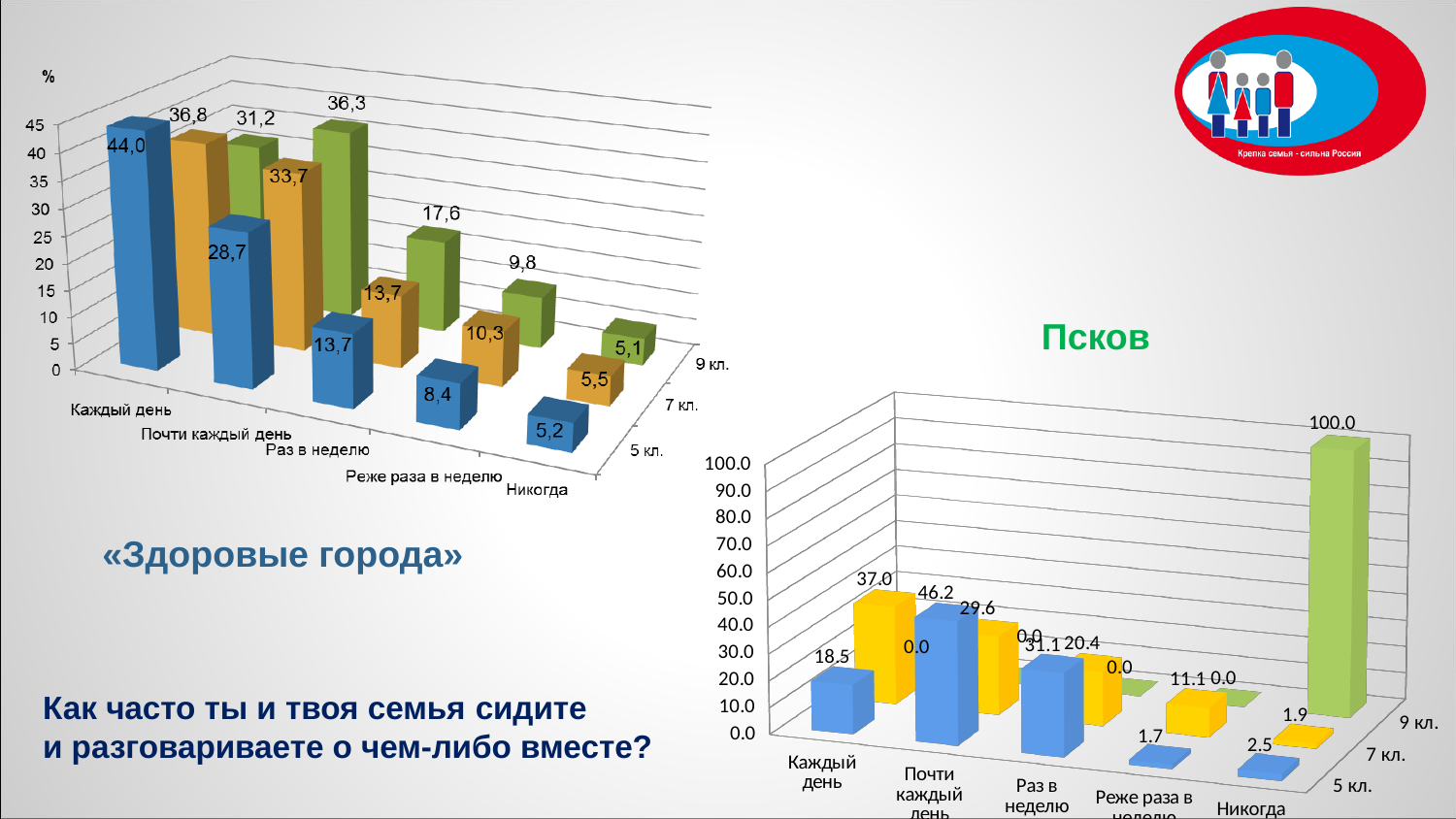
In the «Здоровые города» chart, which category has the highest value for 5 кл.? Каждый день In the «Здоровые города» chart, what is the value for 5 кл. in the «Каждый день» category? 44,0 In the «Псков» chart, what is the value for 5 кл. in the «Почти каждый день» category? 46.2 In the «Здоровые города» chart, how many categories are shown on the x axis? 5 In the «Псков» chart, what is the value for 7 кл. in the «Каждый день» category? 37.0 In the «Здоровые города» chart, what is the difference between the 5 кл. values for «Каждый день» and «Почти каждый день»? 15,3 How many series are plotted in the «Псков» chart? 3 In the «Здоровые города» chart, which is larger for «Реже раза в неделю»: 7 кл. or 5 кл.? 7 кл. In the «Псков» chart, what is the difference between the 5 кл. and 7 кл. values for «Каждый день»? 18.5 What type of chart is the «Псков» chart? Bar chart In the «Здоровые города» chart, what is the value for 9 кл. in the «Почти каждый день» category? 36,3 In the «Псков» chart, what is the value for 9 кл. in the «Никогда» category? 100.0